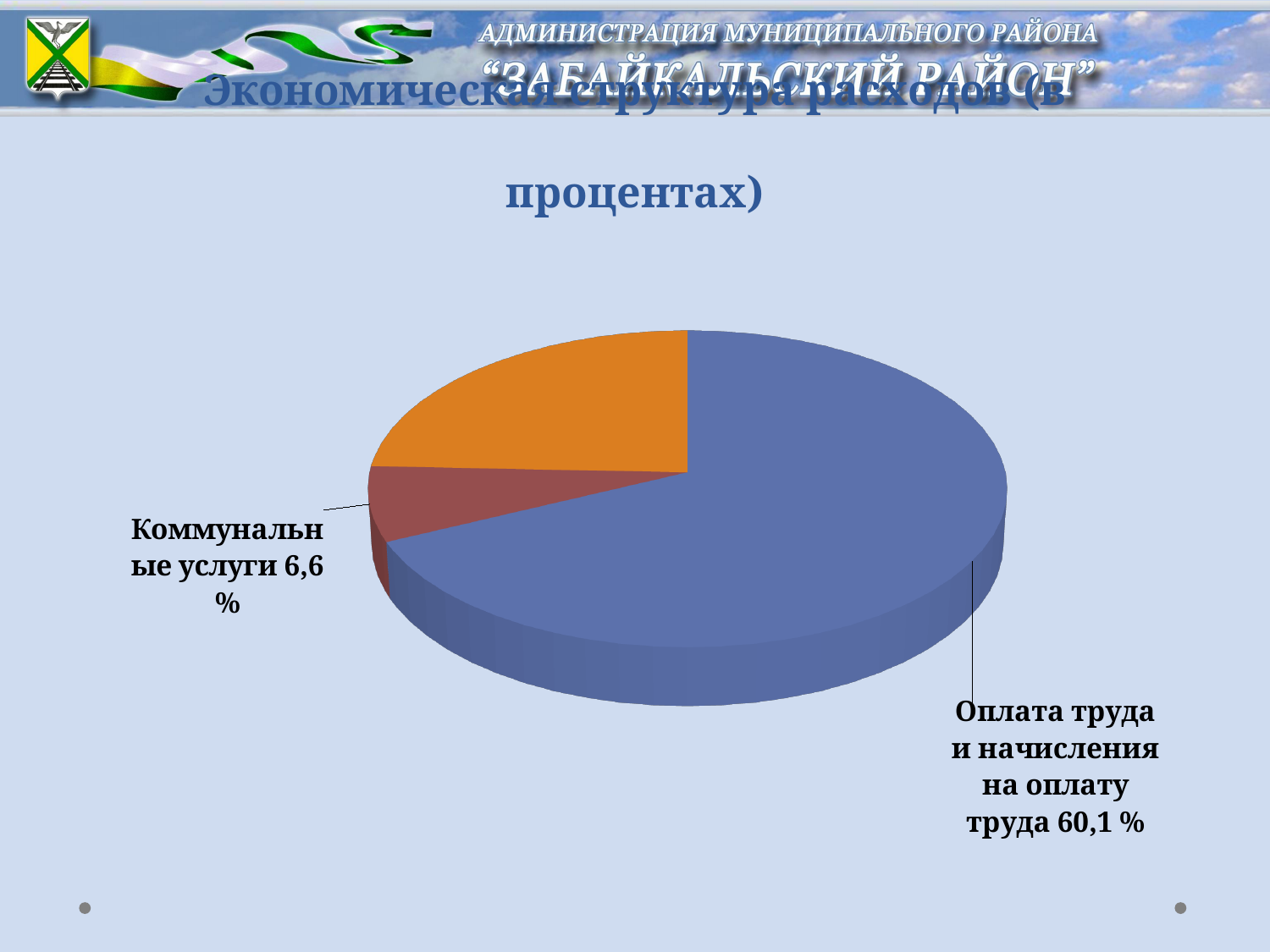
What share of expenses is labelled for "Оплата труда и начисления на оплату труда"? 60,1 % How many slices does the pie chart have? 3 Which is larger: the share for "Оплата труда и начисления на оплату труда" or for "Коммунальные услуги"? Оплата труда и начисления на оплату труда What colour is the slice for "Оплата труда и начисления на оплату труда"? blue Which labelled category has the largest slice of the pie? Оплата труда и начисления на оплату труда What is the difference in percentage points between "Оплата труда и начисления на оплату труда" (60,1 %) and "Коммунальные услуги" (6,6 %)? 53,5 % Is the share for "Коммунальные услуги" greater or less than 10 %? less Is the share for "Оплата труда и начисления на оплату труда" greater or less than 50 %? greater What share of expenses is labelled for "Коммунальные услуги"? 6,6 % Which category has the smallest slice of the pie? Коммунальные услуги What kind of chart is shown on the slide? pie chart What is the title of the chart on the slide? Экономическая структура расходов (в процентах)